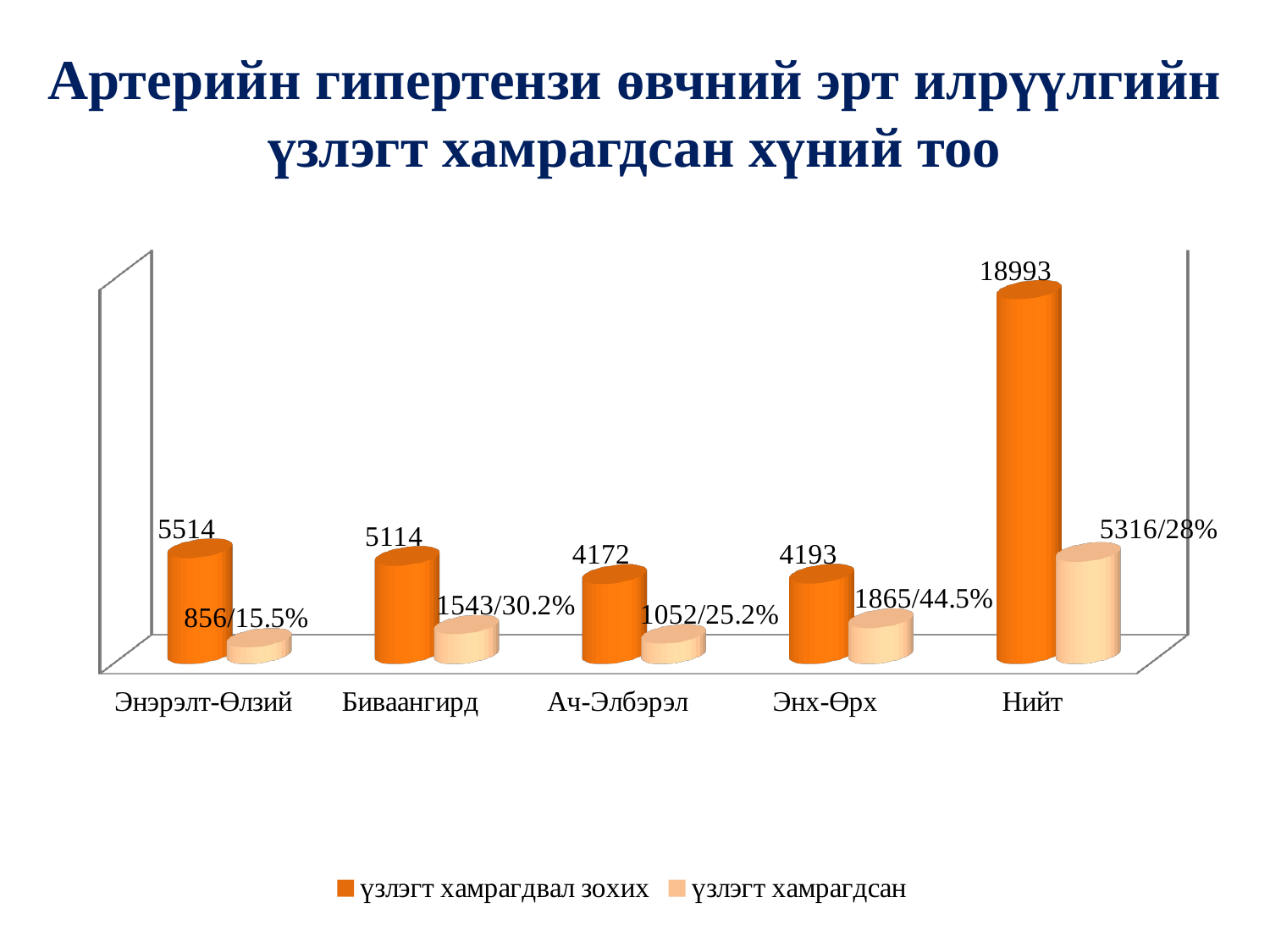
What is the data label for "үзлэгт хамрагдсан" for Биваангирд? 1543/30.2% What kind of chart is shown on the slide? bar chart Which category has the highest value for "үзлэгт хамрагдвал зохих"? Нийт Which is larger: the "үзлэгт хамрагдсан" count for Энх-Өрх or for Биваангирд? Энх-Өрх What is the value of "үзлэгт хамрагдвал зохих" for Энэрэлт-Өлзий? 5514 What is the title of the chart on the slide? Артерийн гипертензи өвчний эрт илрүүлгийн үзлэгт хамрагдсан хүний тоо Which category has the lowest value for "үзлэгт хамрагдвал зохих"? Ач-Элбэрэл What is the value of "үзлэгт хамрагдвал зохих" for Нийт? 18993 How many series does the chart legend list? 2 What is the difference between the "үзлэгт хамрагдвал зохих" values for Энэрэлт-Өлзий and Биваангирд? 400 What is the data label for "үзлэгт хамрагдсан" for Энх-Өрх? 1865/44.5% How many categories are shown on the x axis of the chart? 5